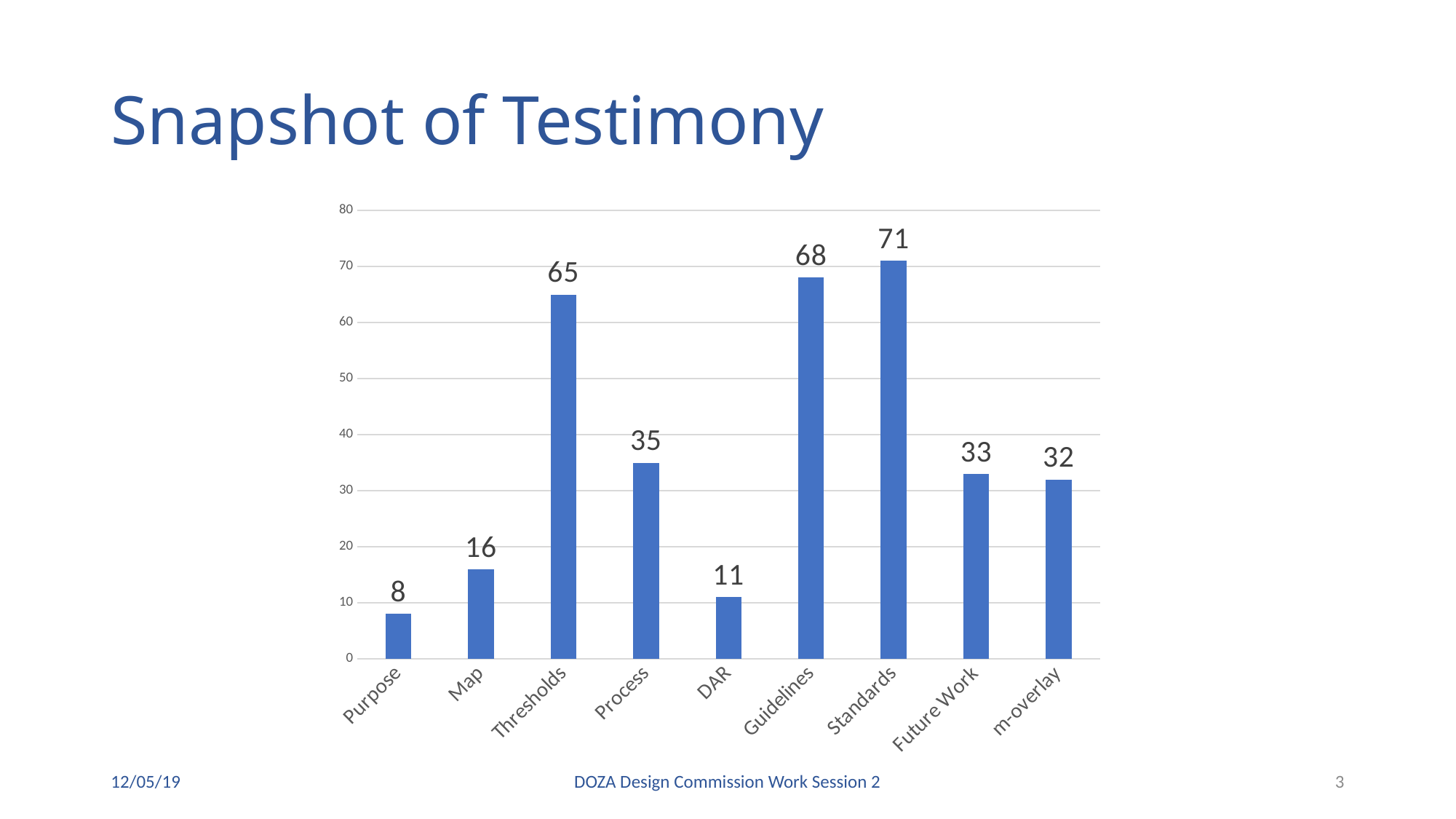
What is the value for Thresholds? 65 What is the difference between the values for Standards and Guidelines? 3 Which category has the lowest value? Purpose What is the value for Future Work? 33 What kind of chart is shown on the slide? bar chart What is the value for DAR? 11 Which is larger, the value for Thresholds or the value for Guidelines? Guidelines What is the title of the slide containing the chart? Snapshot of Testimony What is the difference between the values for Process and Map? 19 How many categories are shown on the x axis? 9 Which category has the highest value? Standards Is the value for m-overlay greater or less than 40? less